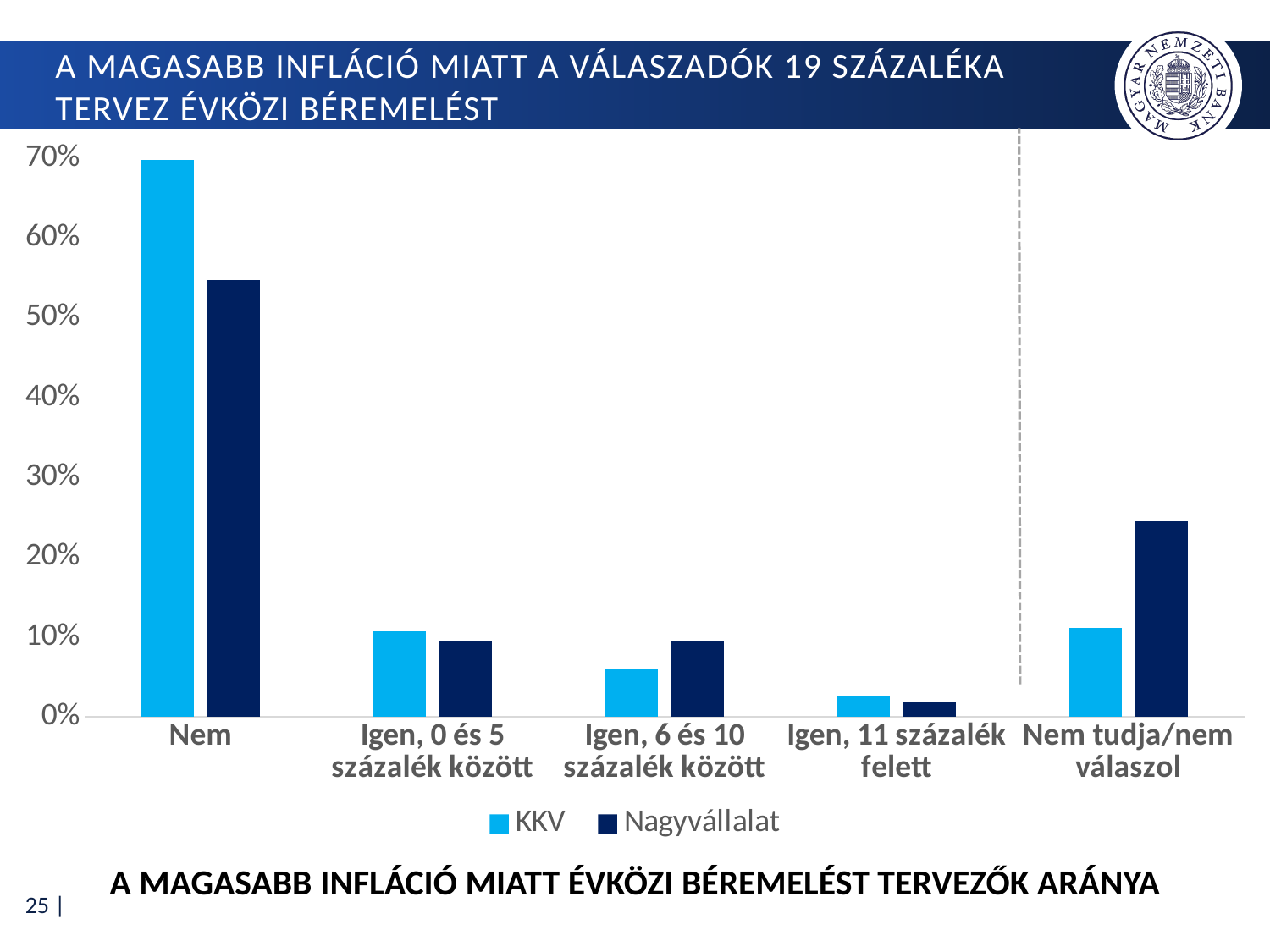
Is the KKV value for Igen, 11 százalék felett greater or less than 10%? less Which category has the lowest value for the Nagyvállalat series? Igen, 11 százalék felett Is the KKV value for Nem greater or less than 60%? greater For the category Nem, which series has the larger value, KKV or Nagyvállalat? KKV Is the Nagyvállalat value for Nem greater or less than 60%? less What are the two series named in the legend? KKV and Nagyvállalat How many categories are shown on the x axis? 5 What kind of chart is shown on the slide? bar chart How many series does the legend list? 2 For the category Nem tudja/nem válaszol, which series has the larger value, KKV or Nagyvállalat? Nagyvállalat Which category has the highest value for the KKV series? Nem